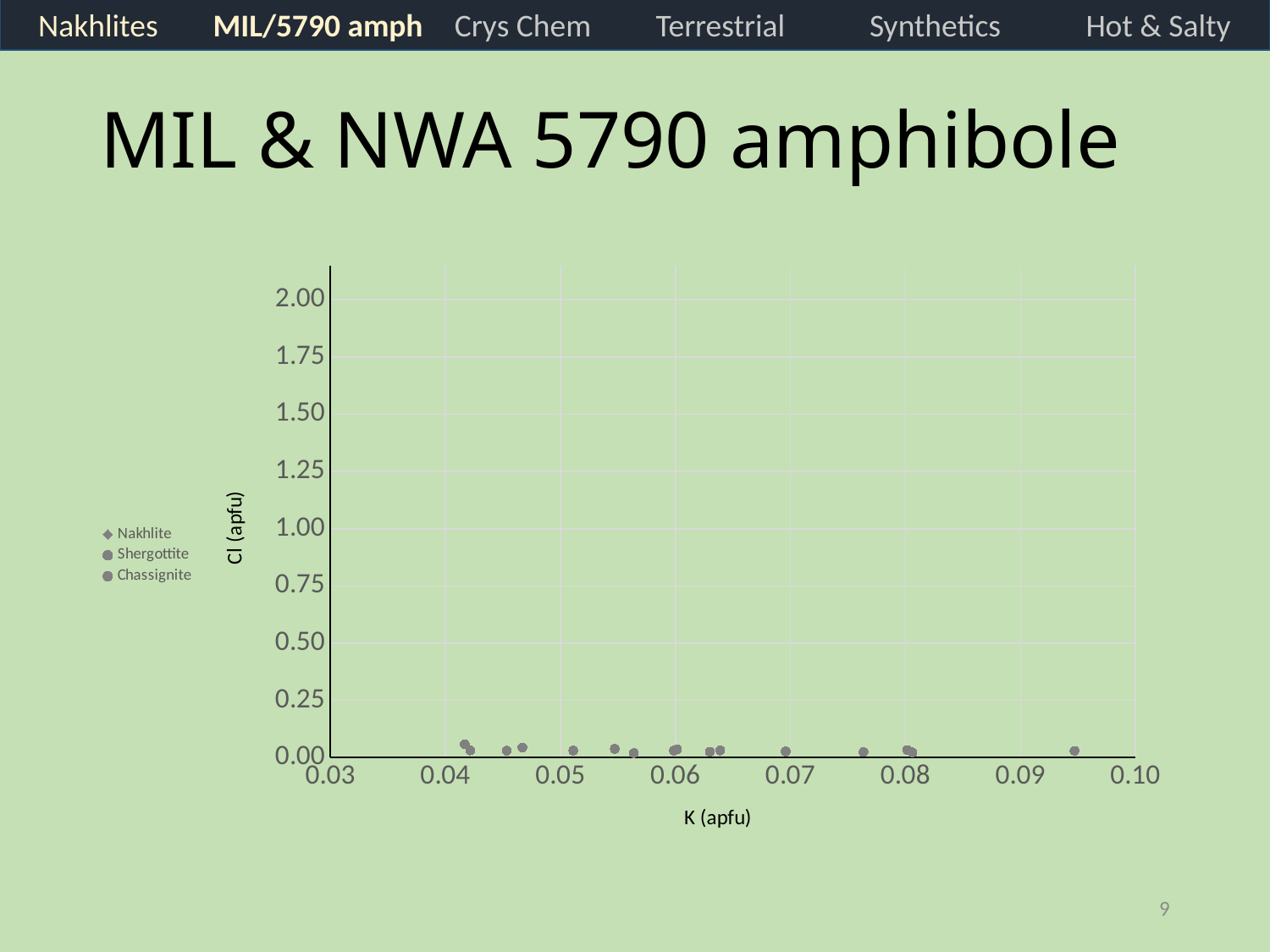
How many series does the legend list? 3 What are the three series named in the legend? Nakhlite, Shergottite, Chassignite Are the plotted Cl (apfu) values greater or less than 0.25? less What is the label of the vertical axis? Cl (apfu) Are any plotted points above 1.00 on the Cl (apfu) axis? No Is the K (apfu) value of the rightmost plotted point greater or less than 0.09? greater What kind of chart is shown on the slide? scatter chart